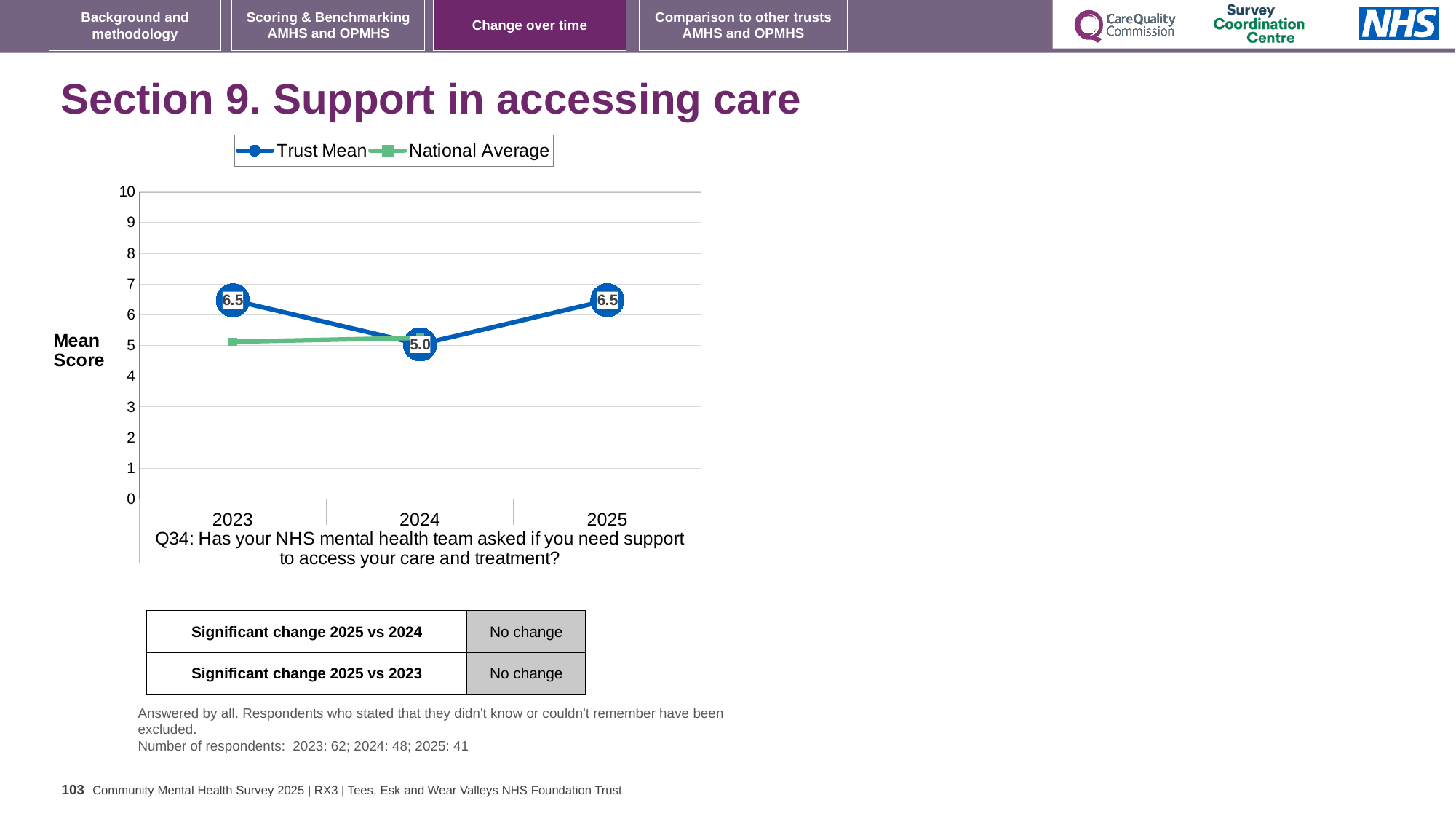
Does the Trust Mean score rise or fall from 2024 to 2025? Rise What kind of chart is shown on the slide? Line chart In which year is the Trust Mean score lowest? 2024 What is the Trust Mean score for 2023? 6.5 Which year has the higher Trust Mean score, 2024 or 2025? 2025 What is the Trust Mean score for 2024? 5.0 How many series does the chart legend list? 2 Is the National Average value for 2024 greater or less than 4? greater How many years are shown on the x axis of the chart? 3 What is the difference between the Trust Mean scores for 2023 and 2024? 1.5 Is the National Average value for 2023 greater or less than 6? less What is the Trust Mean score for 2025? 6.5